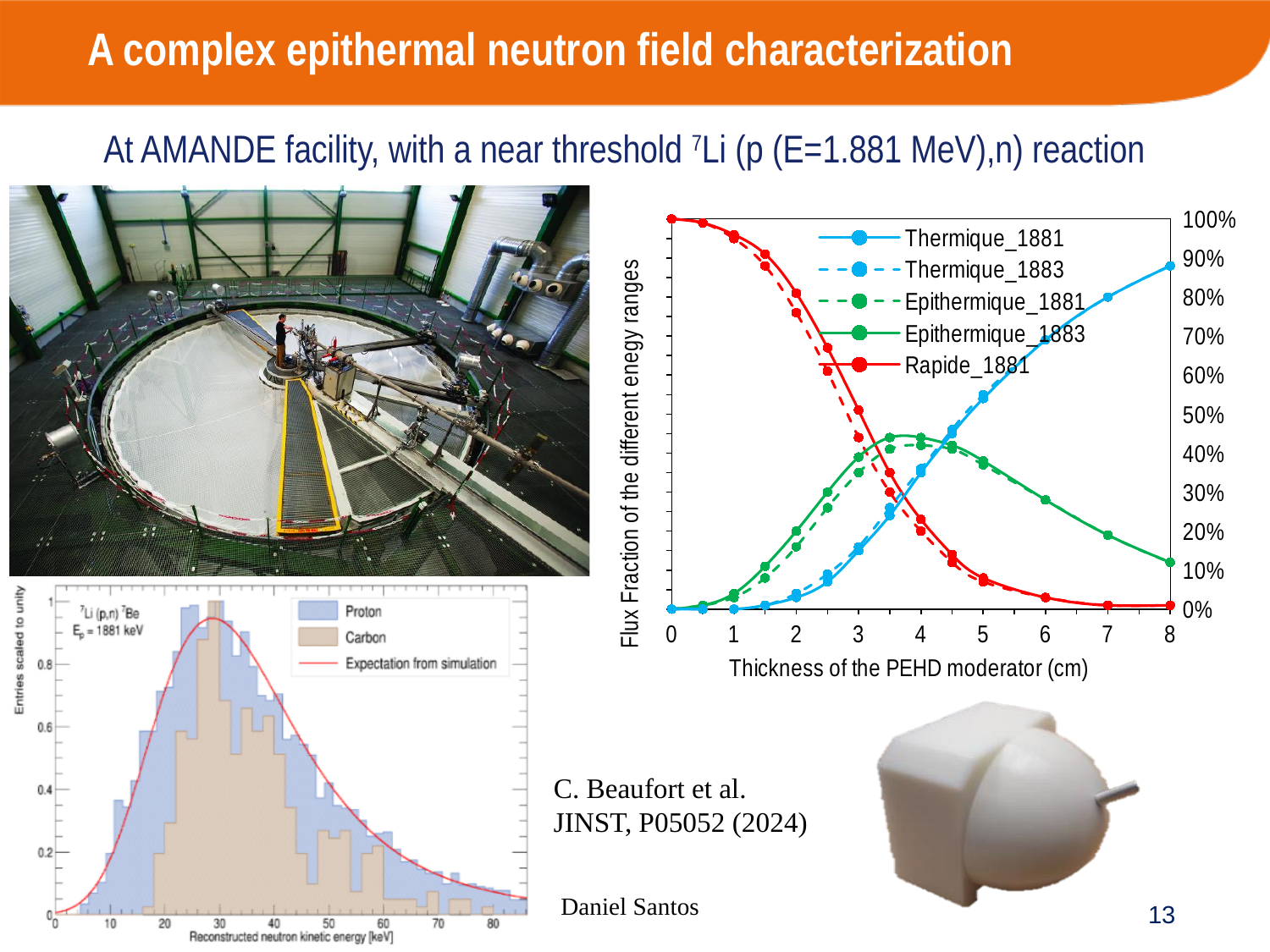
In the flux fraction chart (top right), what is the label of the x axis? Thickness of the PEHD moderator (cm) In the flux fraction chart (top right), is the value of Epithermique_1883 at 8 cm greater or less than 20%? less In the flux fraction chart (top right), what is the value of Thermique_1881 at a thickness of 0 cm? 0% In the flux fraction chart (top right), how many series does the legend list? 5 In the flux fraction chart (top right), what is the value of Rapide_1881 at a thickness of 0 cm? 100% In the flux fraction chart (top right), at a thickness of 6 cm, which is larger: Thermique_1881 or Epithermique_1883? Thermique_1881 In the flux fraction chart (top right), is the value of Thermique_1881 at 8 cm greater or less than 80%? greater In the flux fraction chart (top right), does the Thermique_1881 series rise or fall as the moderator thickness increases? rise In the flux fraction chart (top right), does the Rapide_1881 series rise or fall as the moderator thickness increases? fall In the histogram chart (bottom left), what is the label of the x axis? Reconstructed neutron kinetic energy [keV] In the histogram chart (bottom left), how many entries does the legend list? 3 In the flux fraction chart (top right), which series has the highest value at a thickness of 0 cm? Rapide_1881